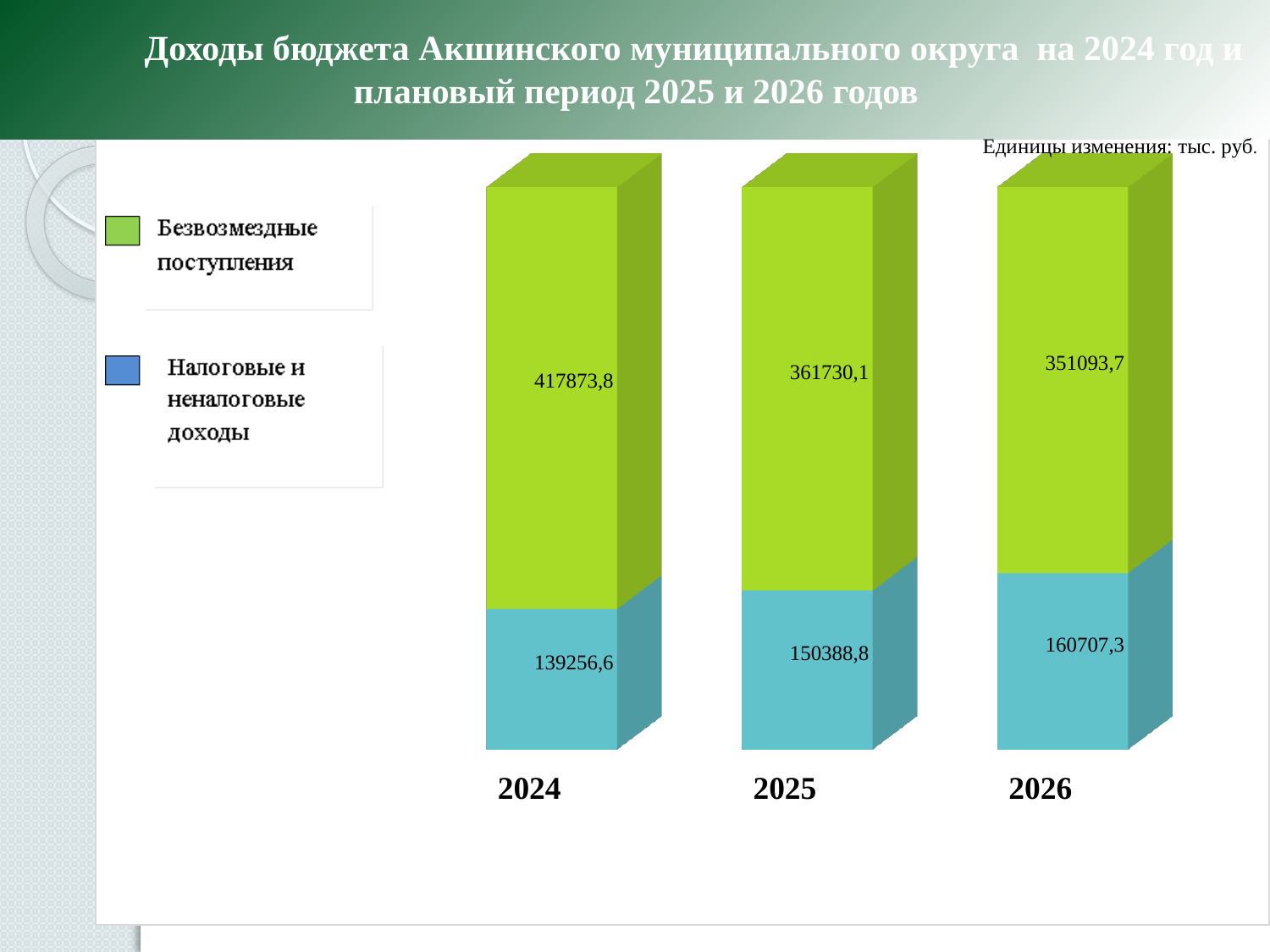
In which year is Налоговые и неналоговые доходы the lowest? 2024 How many years are shown on the x axis? 3 What is the difference between Налоговые и неналоговые доходы in 2026 and in 2024? 21450,7 In which year is Безвозмездные поступления the highest? 2024 Do the values of Налоговые и неналоговые доходы rise or fall from 2024 to 2026? rise How many series does the legend list? 2 What is the difference between Безвозмездные поступления in 2024 and in 2025? 56143,7 What is the total of the stacked bar for 2024? 557130,4 What is the value of Налоговые и неналоговые доходы for 2025? 150388,8 What is the value of Налоговые и неналоговые доходы for 2026? 160707,3 Which is larger: Безвозмездные поступления in 2025 or in 2026? 2025 What is the value of Безвозмездные поступления for 2024? 417873,8